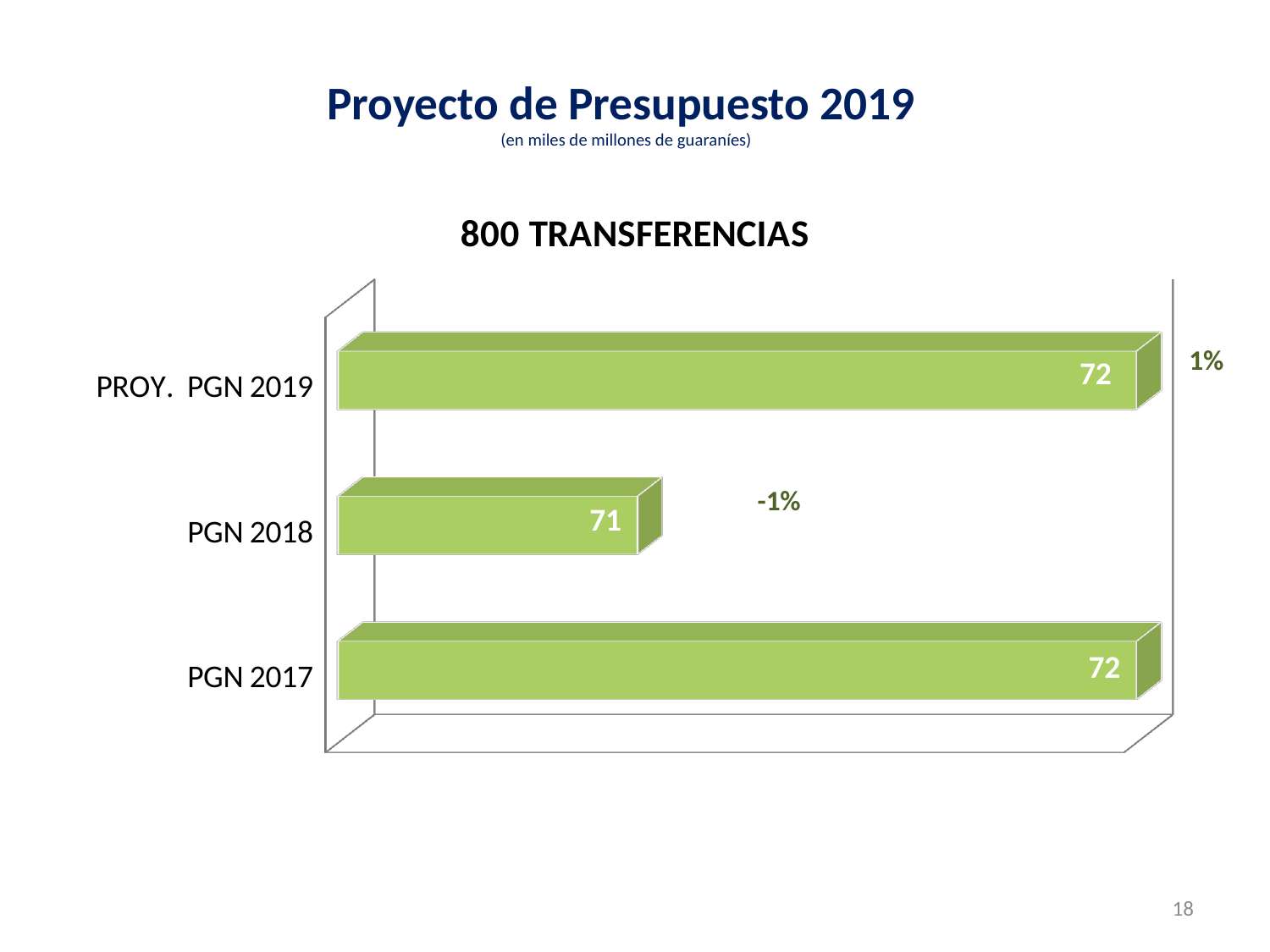
What is the value for PROY. PGN 2019? 72 What percentage change is shown next to the PGN 2018 bar? -1% Which category has the lowest value? PGN 2018 What is the value for PGN 2018? 71 What kind of chart is shown on the slide? bar chart Which is larger, the value for PGN 2018 or the value for PGN 2017? PGN 2017 What is the value for PGN 2017? 72 What is the difference between the values for PROY. PGN 2019 and PGN 2018? 1 In what units are the values expressed, according to the slide subtitle? miles de millones de guaraníes What percentage change is shown next to the PROY. PGN 2019 bar? 1% How many categories are shown in the chart? 3 What is the title of the chart? 800 TRANSFERENCIAS